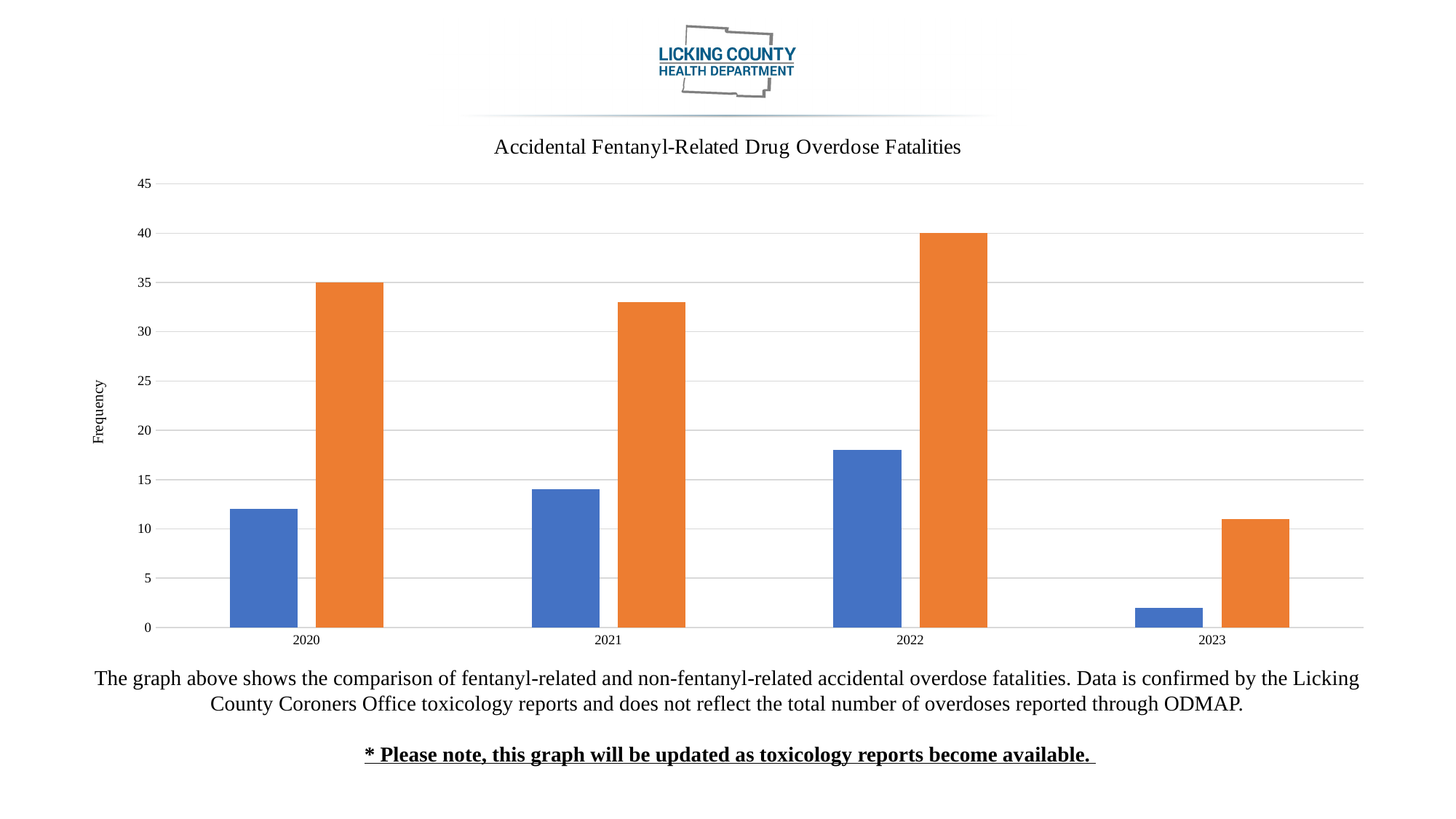
What is the title of the chart? Accidental Fentanyl-Related Drug Overdose Fatalities In 2020, which bar is taller, the blue bar or the orange bar? the orange bar What is the value of the orange bar for 2020? 35 Is the value of the blue bar for 2023 greater or less than 5? less How many years are shown on the x axis of the chart? 4 Which year has the tallest orange bar? 2022 What is the value of the orange bar for 2022? 40 What is the difference between the orange bar for 2022 and the orange bar for 2020? 5 Which year has the tallest blue bar? 2022 What kind of chart is shown on the slide? bar chart Is the value of the blue bar for 2022 greater or less than 15? greater Which year has the shortest blue bar? 2023